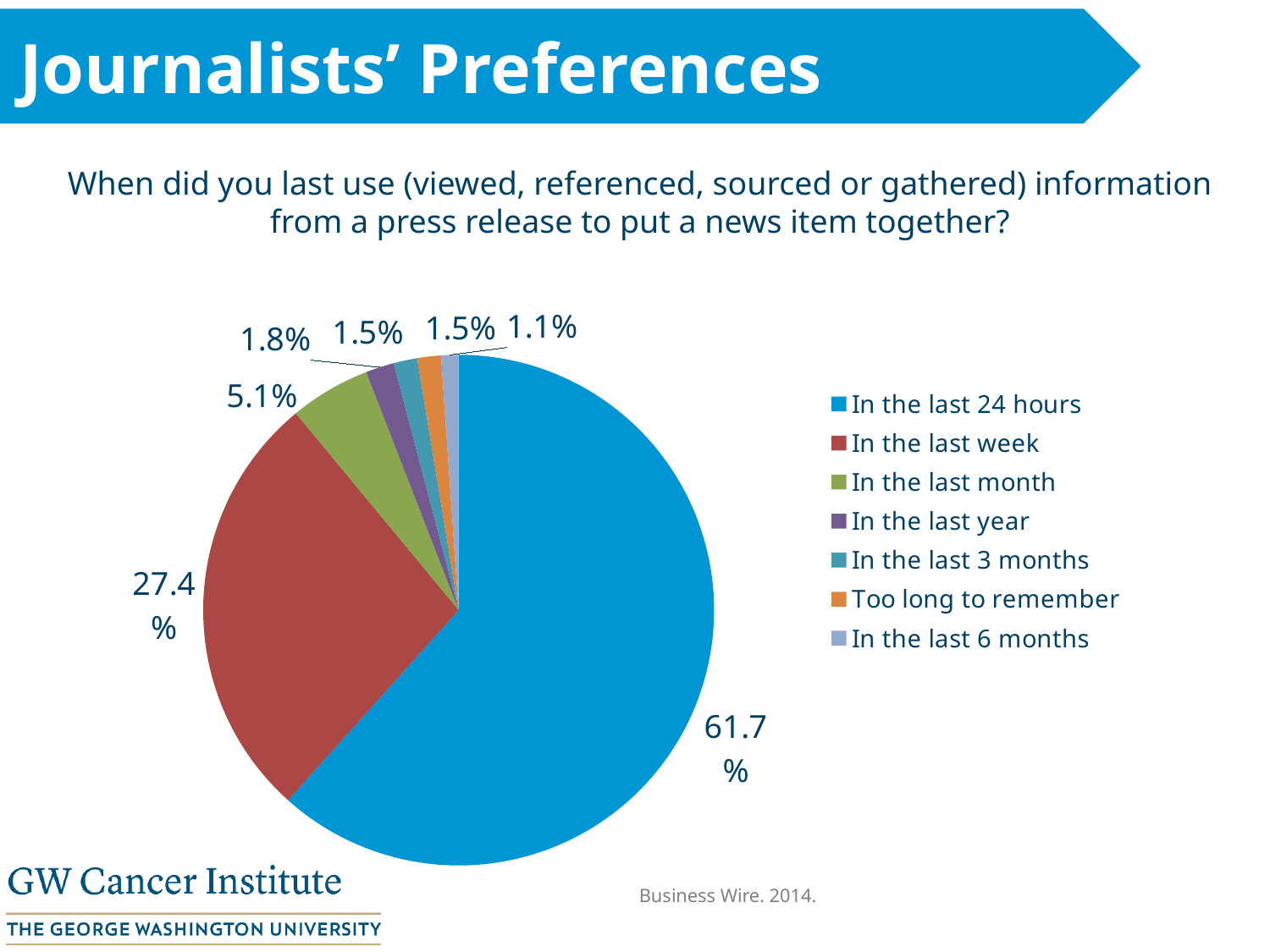
What type of chart is shown on the slide? pie chart Which response category has the largest share of the pie? In the last 24 hours Which is larger: the share for 'In the last month' or the share for 'In the last year'? In the last month What is the difference in percentage points between 'In the last 24 hours' and 'In the last week'? 34.3 What percentage of journalists said they last used a press release in the last year? 1.8% What percentage of journalists said they last used a press release in the last 6 months? 1.1% How many response categories does the legend list? 7 What percentage of journalists said they last used a press release in the last month? 5.1% What colour is the slice for 'Too long to remember'? orange Which response category has the smallest share of the pie? In the last 6 months What percentage of journalists said they last used a press release in the last week? 27.4% What percentage of journalists said they last used a press release in the last 24 hours? 61.7%